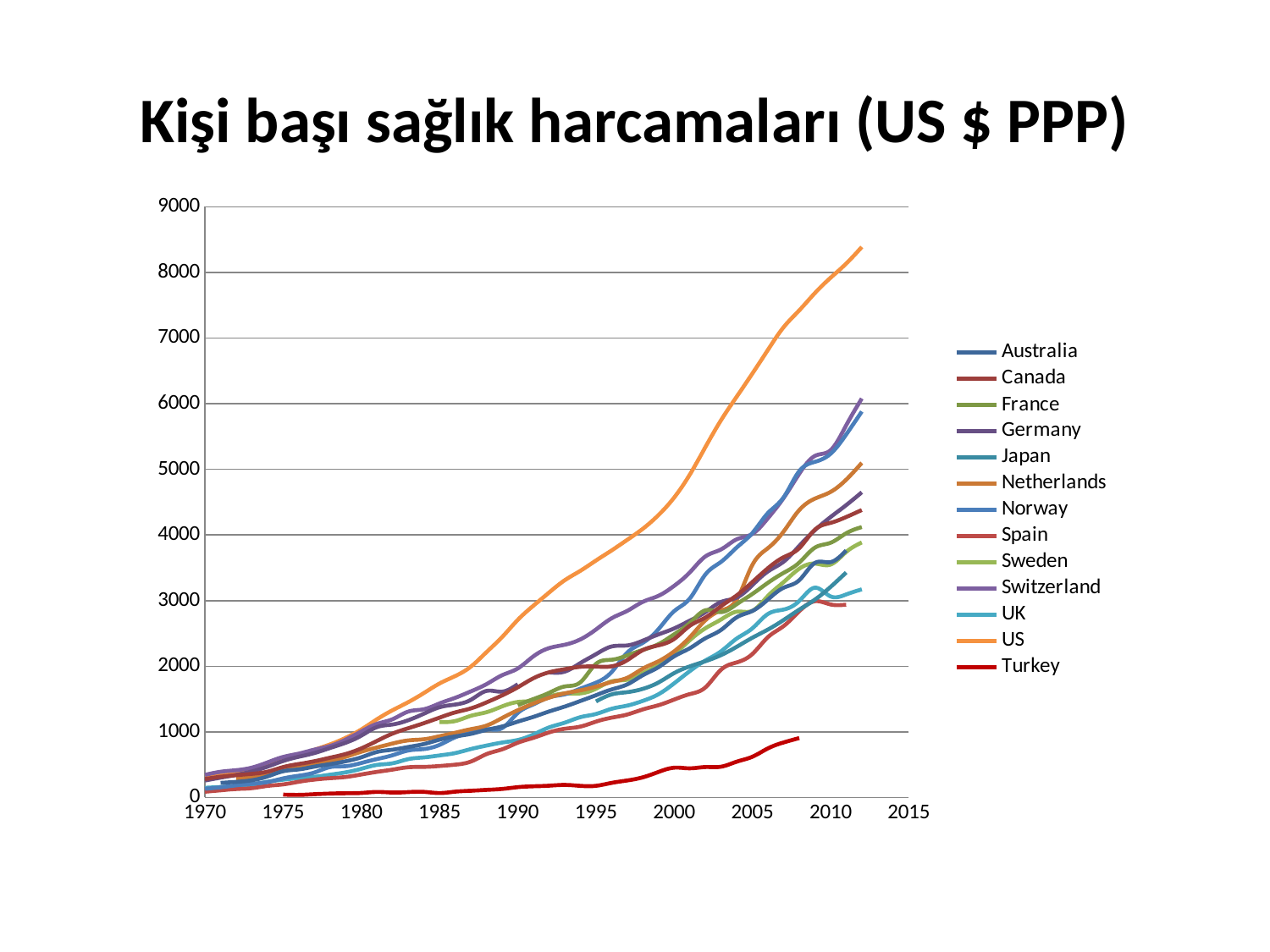
Which is larger in 2010, the value for the US or the value for Switzerland? US Is the value for Switzerland in 2012 greater or less than 5000? greater What colour is the line for Turkey in the legend? red Is the value for the US in 2010 greater or less than 7000? greater Is the value for Turkey in 2005 greater or less than 1000? less How many series does the legend list? 13 What is the title of the chart? Kişi başı sağlık harcamaları (US $ PPP) Which country has the highest per-capita health spending at the end of the period shown? US Does the US line rise or fall from 1970 to 2012? rise What kind of chart is shown on the slide? line chart Which country has the lowest per-capita health spending throughout the chart? Turkey